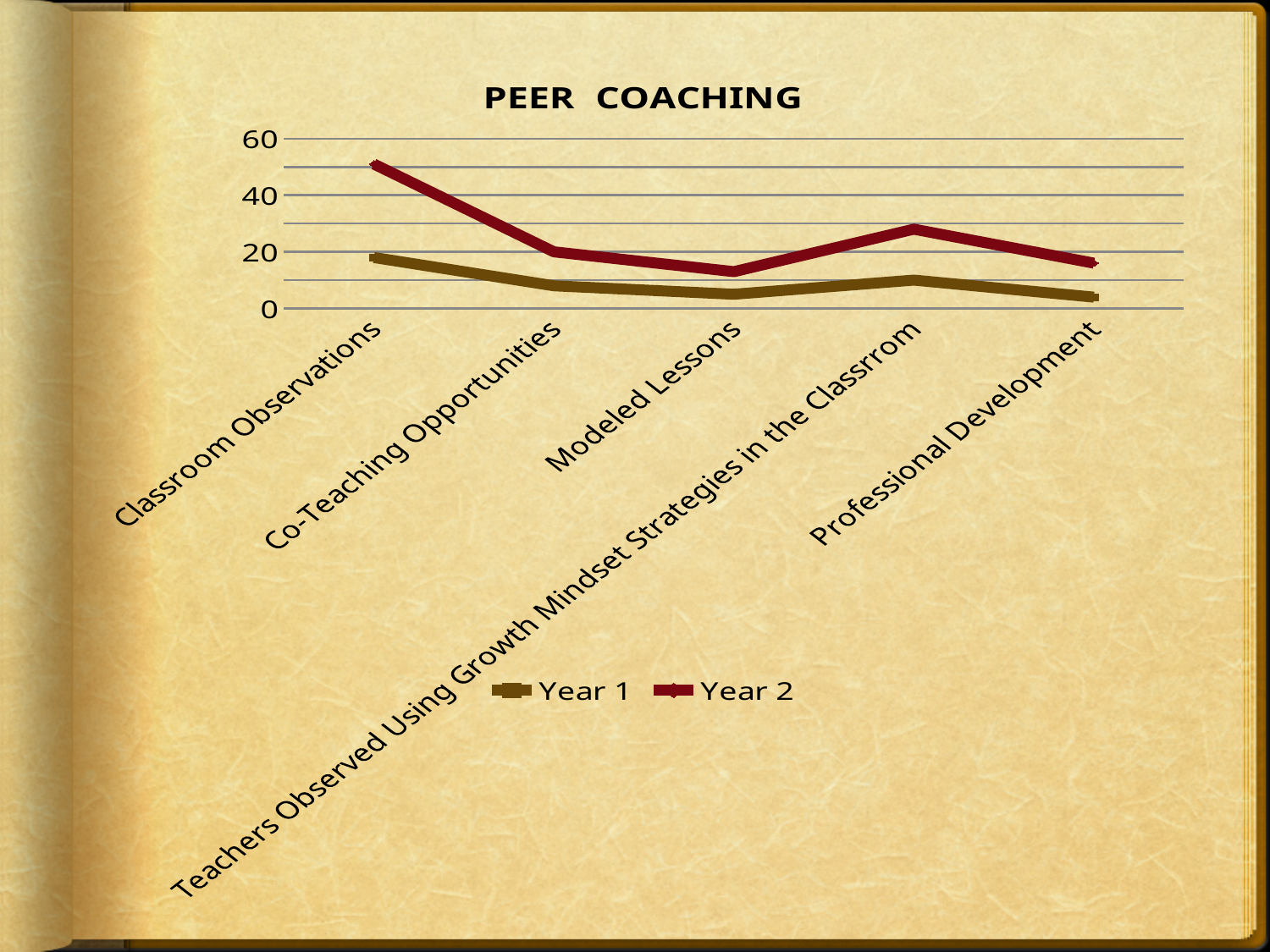
Is the Year 1 value for Classroom Observations greater or less than 10? greater Does the Year 2 line rise or fall from Classroom Observations to Modeled Lessons? fall What kind of chart is shown on the slide? line chart Which category has the highest Year 1 value? Classroom Observations How many categories are plotted along the x axis? 5 What is the title of the chart? PEER COACHING Which category has the highest Year 2 value? Classroom Observations How many series does the legend list? 2 Which category has the lowest Year 2 value? Modeled Lessons For Teachers Observed Using Growth Mindset Strategies in the Classrrom, which series has the larger value, Year 1 or Year 2? Year 2